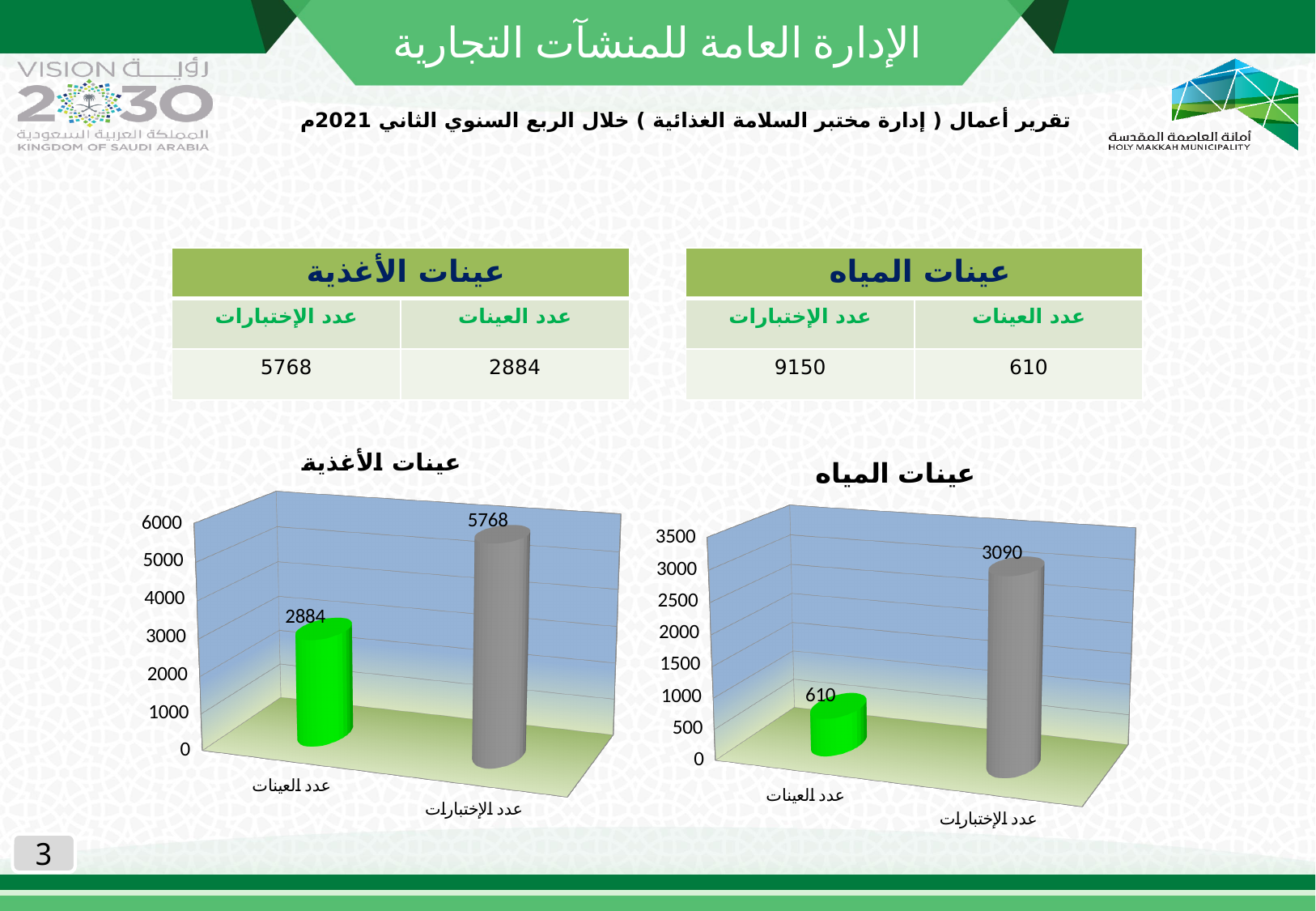
In the chart titled عينات الأغذية, which category has the highest value? عدد الإختبارات In the chart titled عينات المياه, what is the difference between عدد الإختبارات and عدد العينات? 2480 In the chart titled عينات الأغذية, what is the difference between عدد الإختبارات and عدد العينات? 2884 In the chart titled عينات المياه, is the value for عدد العينات greater or less than 1000? less In the chart titled عينات المياه, what is the value for عدد العينات? 610 In the chart titled عينات المياه, what is the value for عدد الإختبارات? 3090 What kind of chart is the chart titled عينات المياه? bar chart In the chart titled عينات الأغذية, what is the value for عدد الإختبارات? 5768 How many categories are shown in the chart titled عينات الأغذية? 2 In the chart titled عينات الأغذية, what colour is the bar for عدد العينات? green In the chart titled عينات المياه, which category has the lowest value? عدد العينات In the chart titled عينات الأغذية, what is the value for عدد العينات? 2884